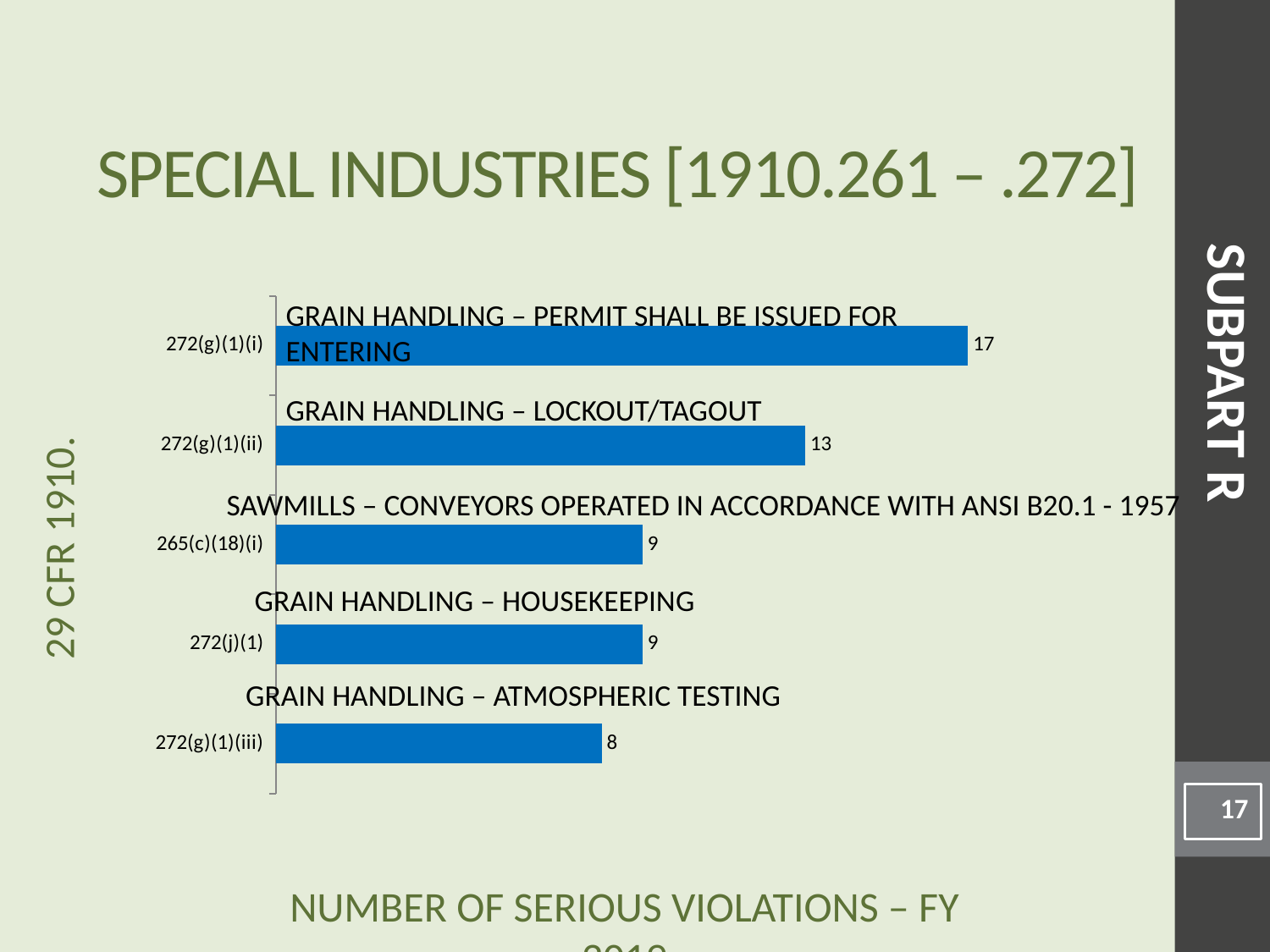
What kind of chart is shown on the slide? Bar chart What is the difference between the number of serious violations for 272(g)(1)(ii) and 272(j)(1)? 4 What is the number of serious violations for 272(g)(1)(i)? 17 What is the number of serious violations for 272(g)(1)(ii)? 13 Which standard is labelled 'GRAIN HANDLING – LOCKOUT/TAGOUT' in the chart? 272(g)(1)(ii) Which has more serious violations, 272(g)(1)(ii) or 265(c)(18)(i)? 272(g)(1)(ii) What is the difference between the number of serious violations for 272(g)(1)(i) and 272(g)(1)(ii)? 4 What is the number of serious violations for 272(g)(1)(iii)? 8 Which standard has the lowest number of serious violations? 272(g)(1)(iii) How many standards (bars) are shown in the chart? 5 Which standard has the highest number of serious violations? 272(g)(1)(i) What is the number of serious violations for 265(c)(18)(i)? 9